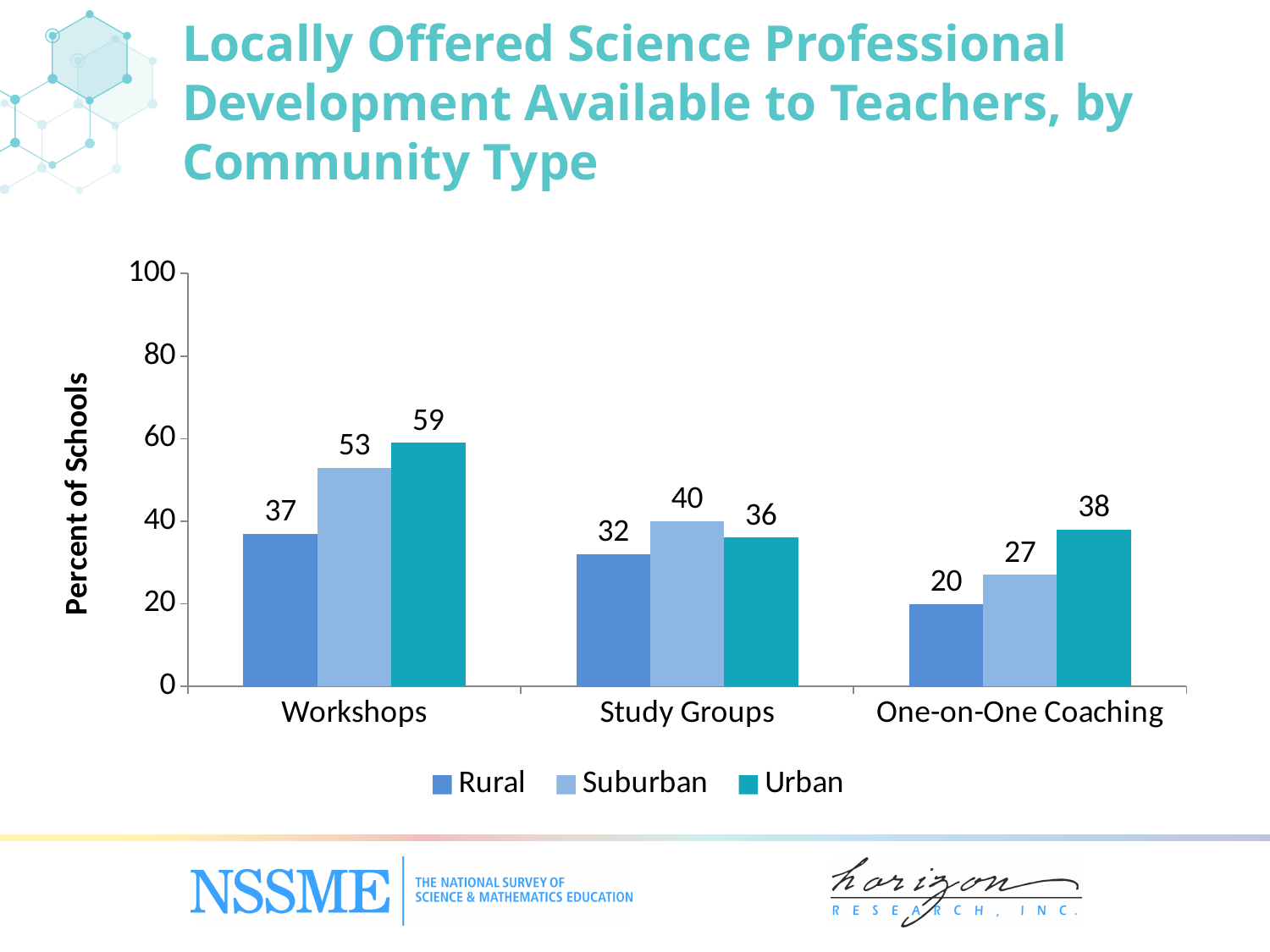
What kind of chart is shown on the slide? Bar chart Which community type has the highest value for Workshops? Urban What is the value for Suburban in the Study Groups category? 40 What is the value for Urban in the Workshops category? 59 Which is larger for Study Groups: the Suburban value or the Urban value? Suburban What is the label of the y axis? Percent of Schools How many series does the legend list? 3 Is the value for Suburban in the Workshops category greater or less than 40? greater How many categories are shown on the x axis? 3 What is the difference between the Urban and Rural values for Workshops? 22 Which community type has the lowest value for Study Groups? Rural What is the value for Rural in the One-on-One Coaching category? 20